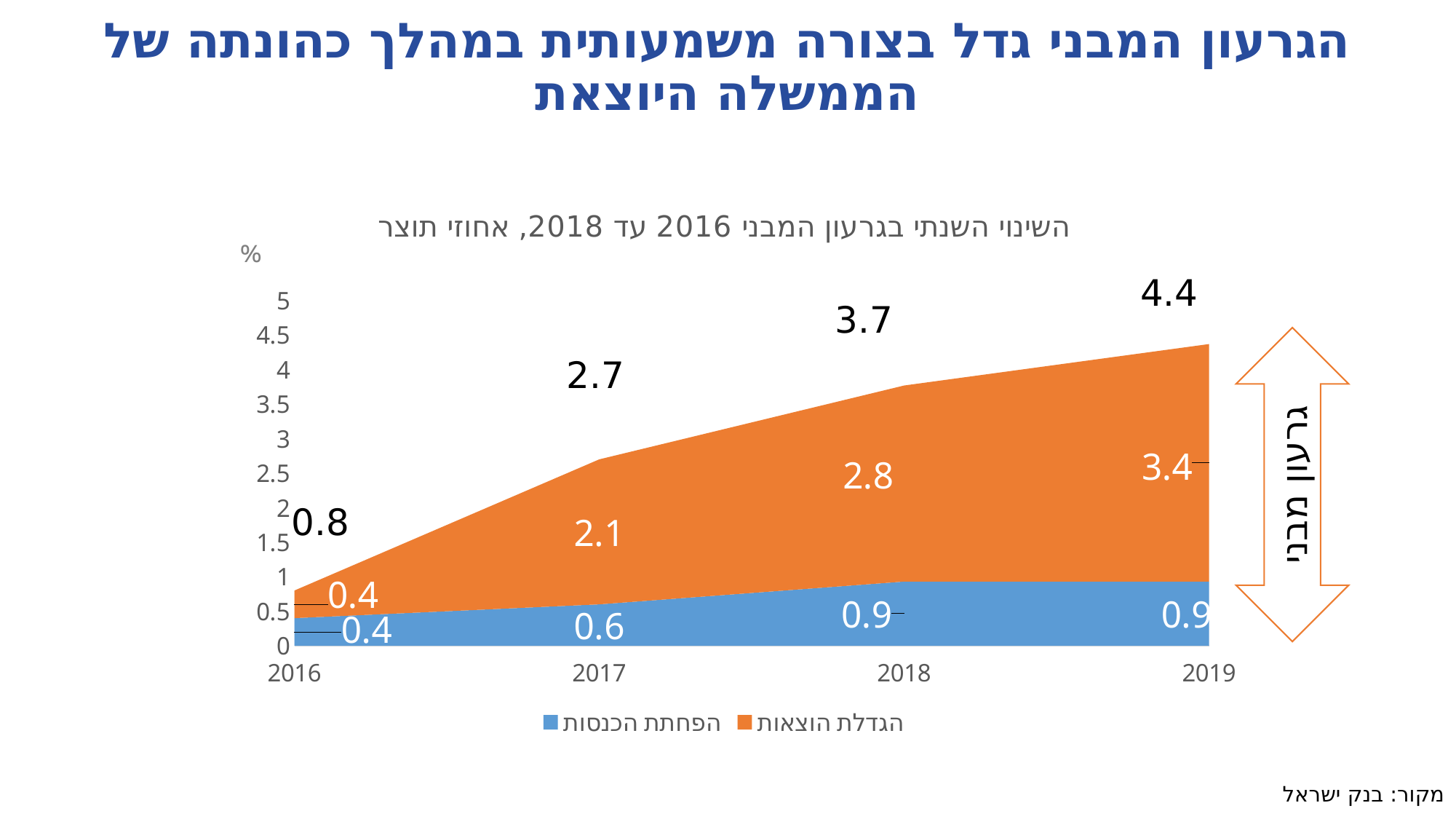
Which is larger in 2017: הגדלת הוצאות or הפחתת הכנסות? הגדלת הוצאות What is the value of הפחתת הכנסות in 2017? 0.6 Does the total value rise or fall from 2016 to 2019? rise What is the value of הגדלת הוצאות in 2019? 3.4 How many years are shown on the x axis? 4 What is the total value shown for 2016? 0.8 What is the total value shown for 2018? 3.7 In which year is the total value highest? 2019 What is the value of הגדלת הוצאות in 2016? 0.4 In which year is the value of הגדלת הוצאות lowest? 2016 What is the difference between the הגדלת הוצאות values in 2019 and 2018? 0.6 How many series does the legend list? 2